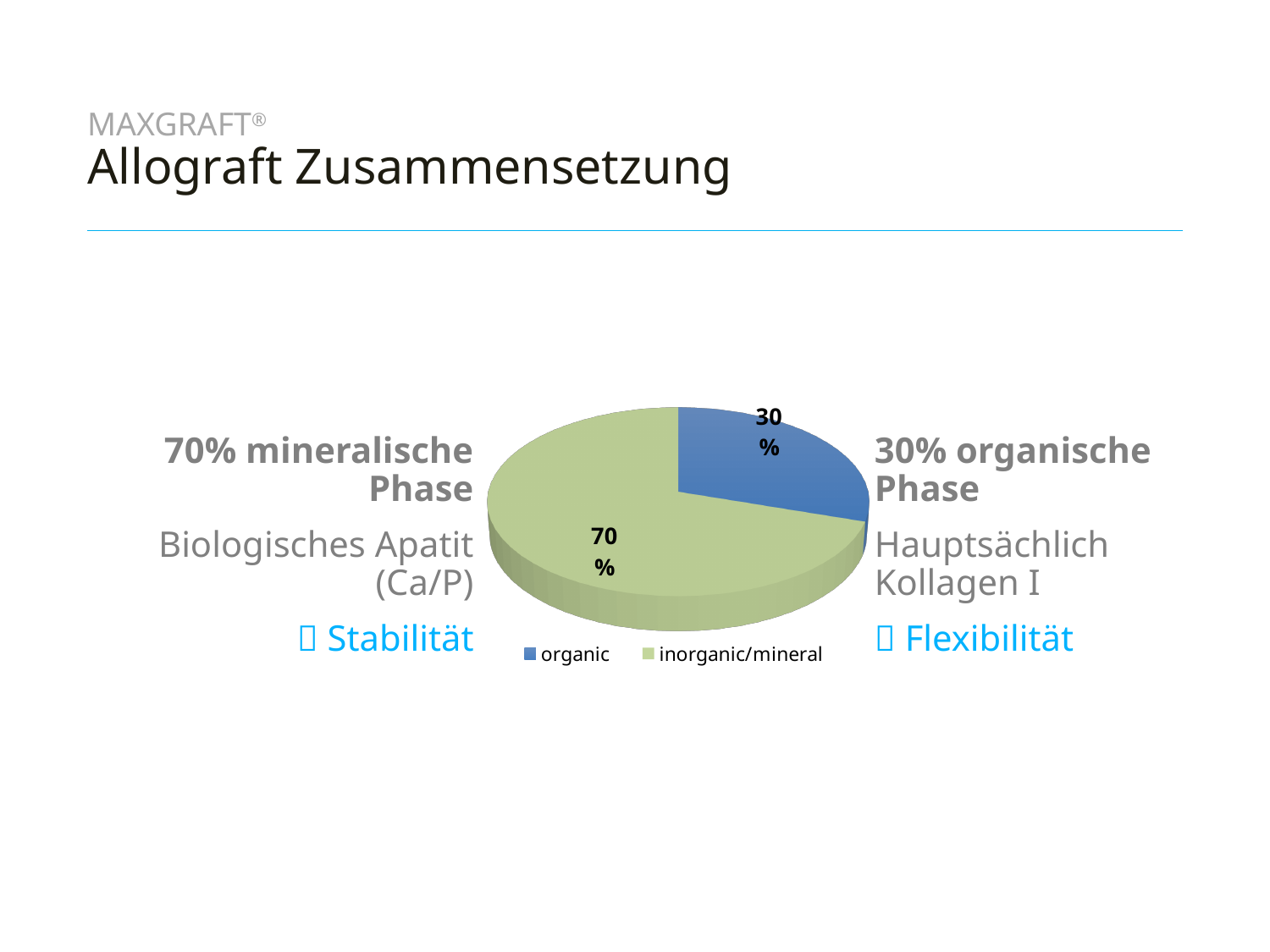
What colour is the inorganic/mineral slice in the pie chart? green What are the two legend entries of the pie chart? organic, inorganic/mineral Which is larger, the organic slice or the inorganic/mineral slice? inorganic/mineral What is the difference between the inorganic/mineral and organic slices? 40% What is the value shown for the inorganic/mineral slice of the pie chart? 70% What share of the pie does the organic slice represent? 30% What kind of chart is shown on the slide? pie chart How many entries does the legend of the pie chart list? 2 What is the value shown for the organic slice of the pie chart? 30% Which slice of the pie chart is the largest? inorganic/mineral How many slices does the pie chart have? 2 Which slice of the pie chart is the smallest? organic